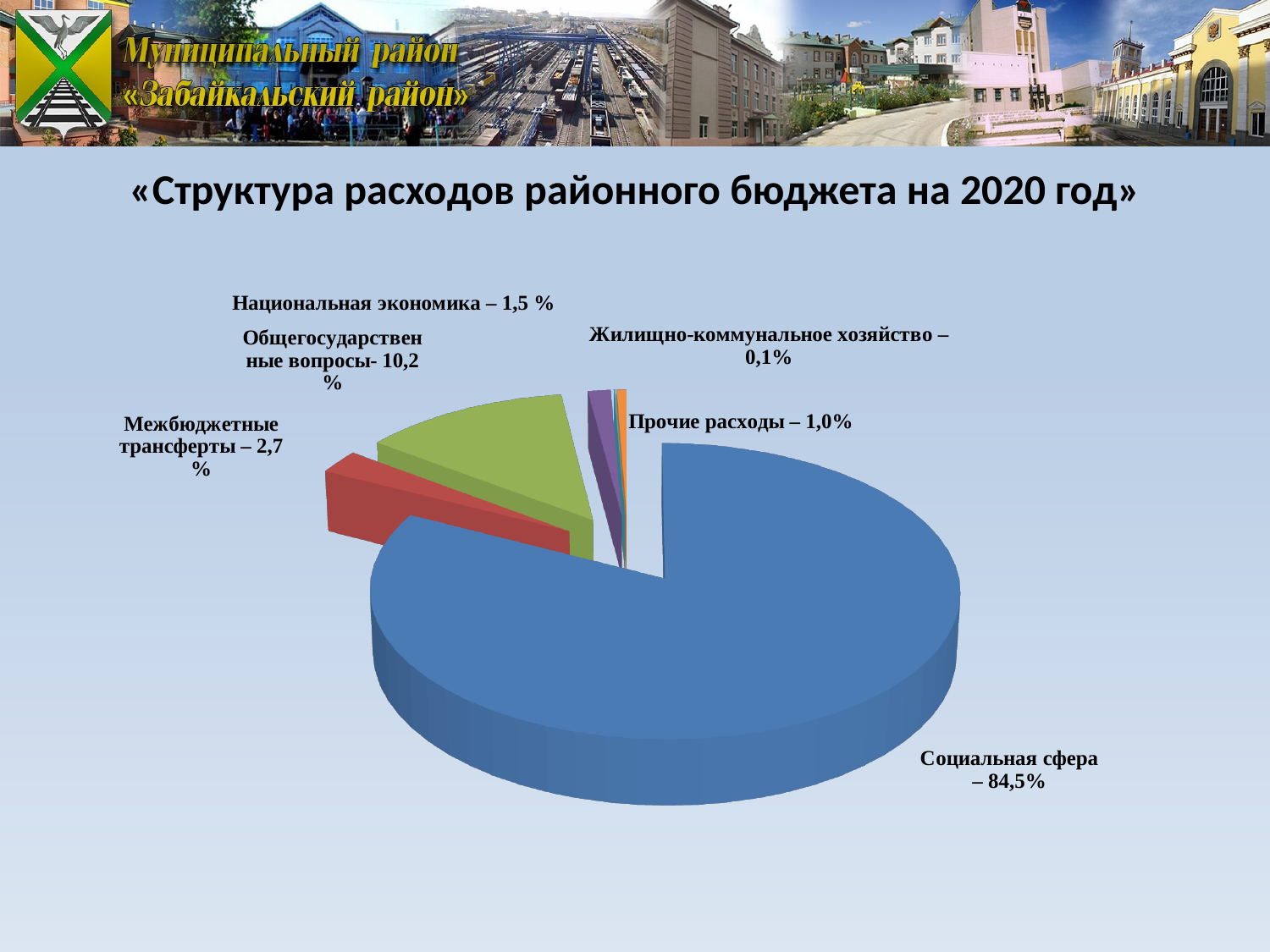
Which expenditure category has the smallest share of the pie? Жилищно-коммунальное хозяйство What type of chart is used on the slide? Pie chart What percentage is shown for Межбюджетные трансферты? 2,7% What is the difference in percentage points between Социальная сфера and Общегосударственные вопросы? 74,3 What share of the 2020 district budget expenditures goes to Социальная сфера? 84,5% What percentage is shown for Национальная экономика? 1,5% Which is larger: the share for Межбюджетные трансферты or for Прочие расходы? Межбюджетные трансферты What is the title of the chart on the slide? «Структура расходов районного бюджета на 2020 год» How many categories (slices) does the pie chart show? 6 Which expenditure category has the largest share of the pie? Социальная сфера What share is labelled for Жилищно-коммунальное хозяйство? 0,1% What share of expenditures is labelled for Общегосударственные вопросы? 10,2%